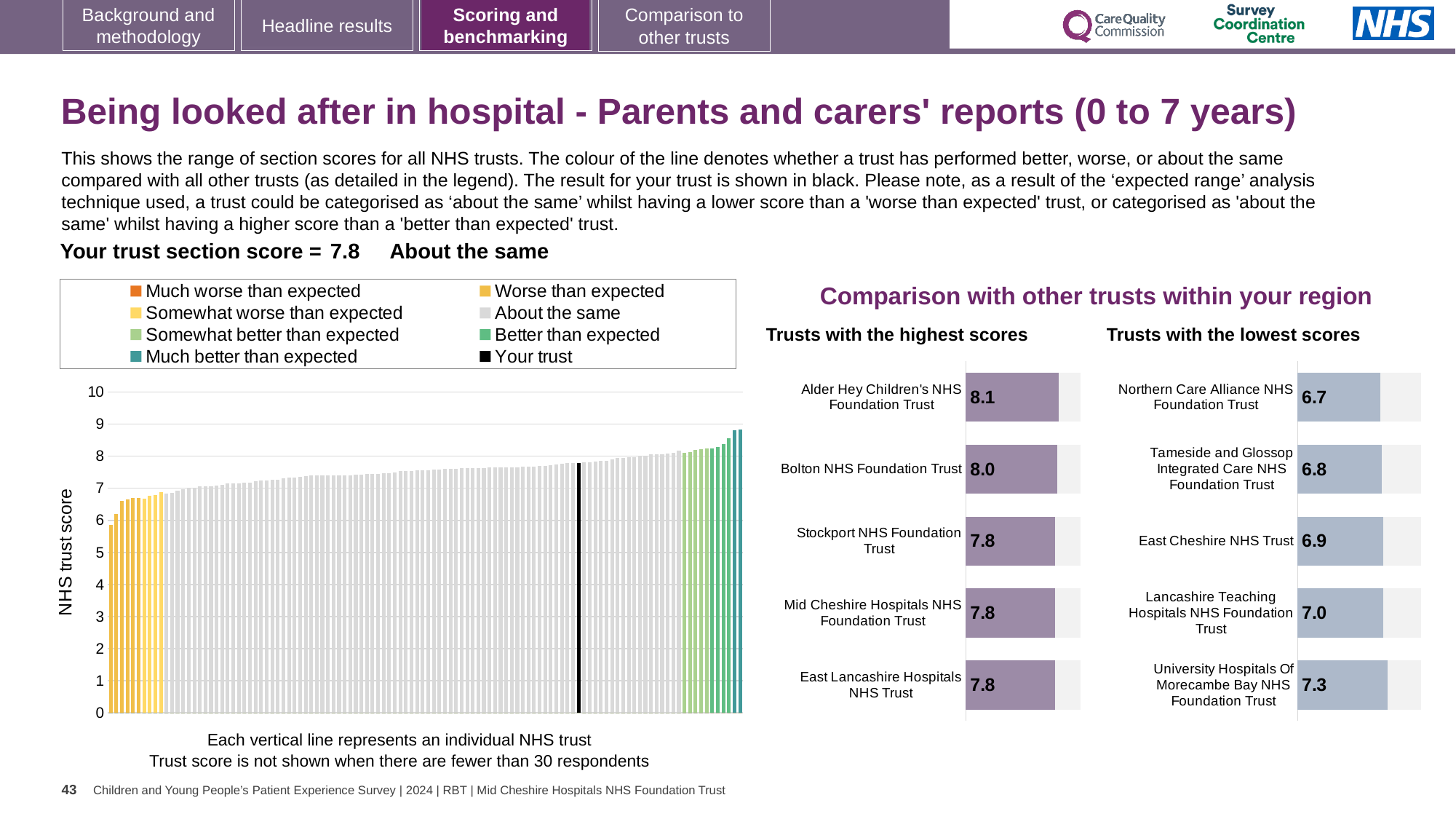
In the 'Trusts with the highest scores' chart, what is the difference between the scores of Alder Hey Children's NHS Foundation Trust and Stockport NHS Foundation Trust? 0.3 In the 'Trusts with the lowest scores' chart, what is the difference between the scores of University Hospitals Of Morecambe Bay NHS Foundation Trust and Northern Care Alliance NHS Foundation Trust? 0.6 In the large chart on the left, is the value for the lowest-scoring trust (leftmost bar) greater or less than 7? less In the 'Trusts with the lowest scores' chart, which trust has the lowest score? Northern Care Alliance NHS Foundation Trust In the 'Trusts with the highest scores' chart, what is the score for Bolton NHS Foundation Trust? 8.0 In the 'Trusts with the highest scores' chart, what is the score for Alder Hey Children's NHS Foundation Trust? 8.1 How many entries does the legend of the large chart on the left list? 8 In the 'Trusts with the lowest scores' chart, what is the score for East Cheshire NHS Trust? 6.9 How many trusts are listed in the 'Trusts with the highest scores' chart? 5 In the 'Trusts with the lowest scores' chart, which has the higher score: Tameside and Glossop Integrated Care NHS Foundation Trust or Lancashire Teaching Hospitals NHS Foundation Trust? Lancashire Teaching Hospitals NHS Foundation Trust In the large chart on the left, do the trust scores rise or fall from left to right along the x axis? rise In the 'Trusts with the lowest scores' chart, which trust has the highest score? University Hospitals Of Morecambe Bay NHS Foundation Trust